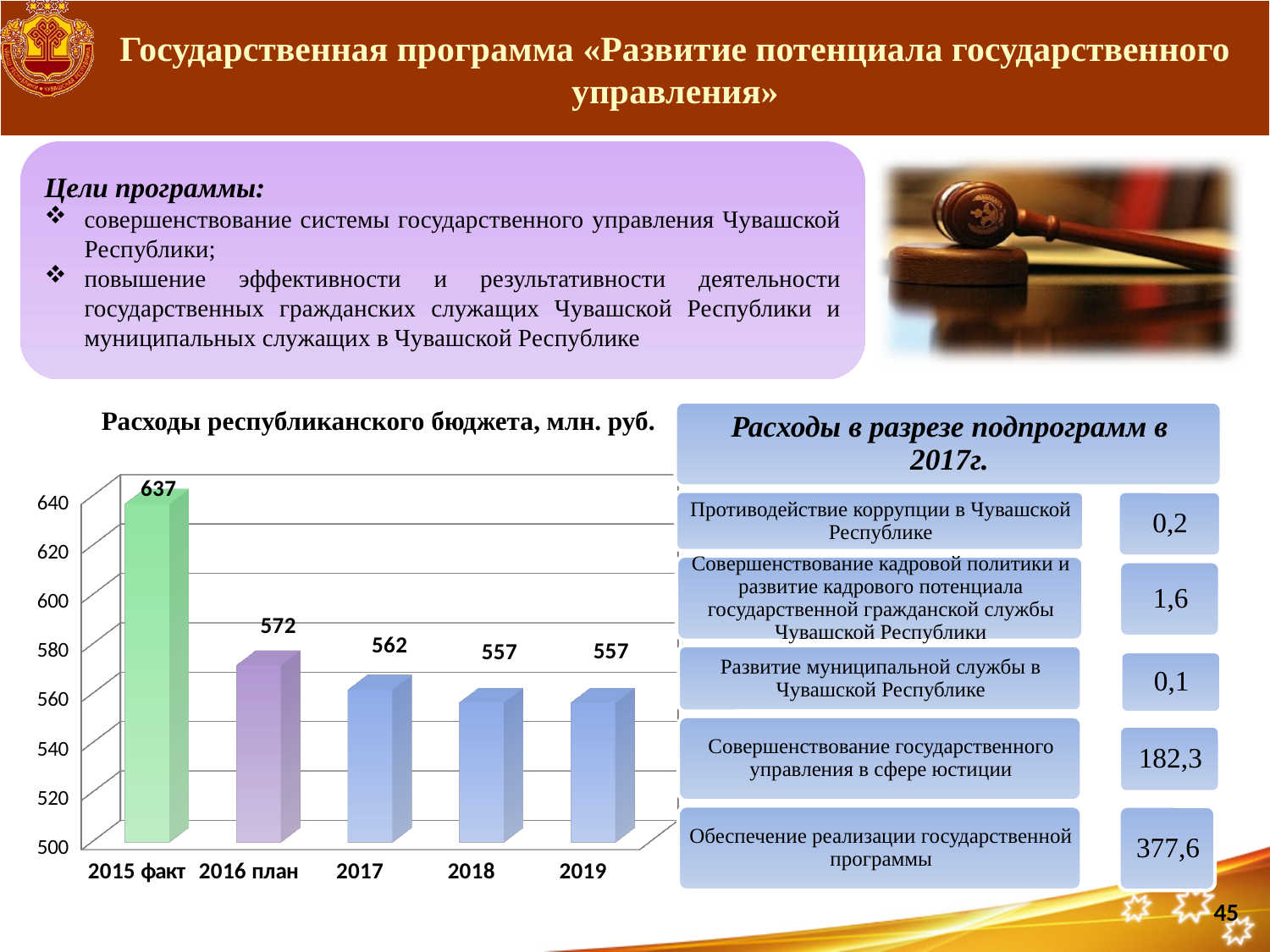
What is the difference between the values for 2017 and 2018? 5 What is the value for 2019 in the chart? 557 Is the value for 2018 greater or less than 600? less What is the value for 2015 факт in the chart 'Расходы республиканского бюджета, млн. руб.'? 637 Do the values in the chart generally rise or fall from 2015 факт to 2019? fall Which category has the highest value in the chart? 2015 факт Which is larger, the value for 2016 план or the value for 2017? 2016 план What is the value for 2017 in the chart? 562 How many categories are shown on the x axis of the chart? 5 What is the value for 2016 план in the chart? 572 What is the difference between the values for 2015 факт and 2016 план? 65 What kind of chart is shown on the slide? bar chart